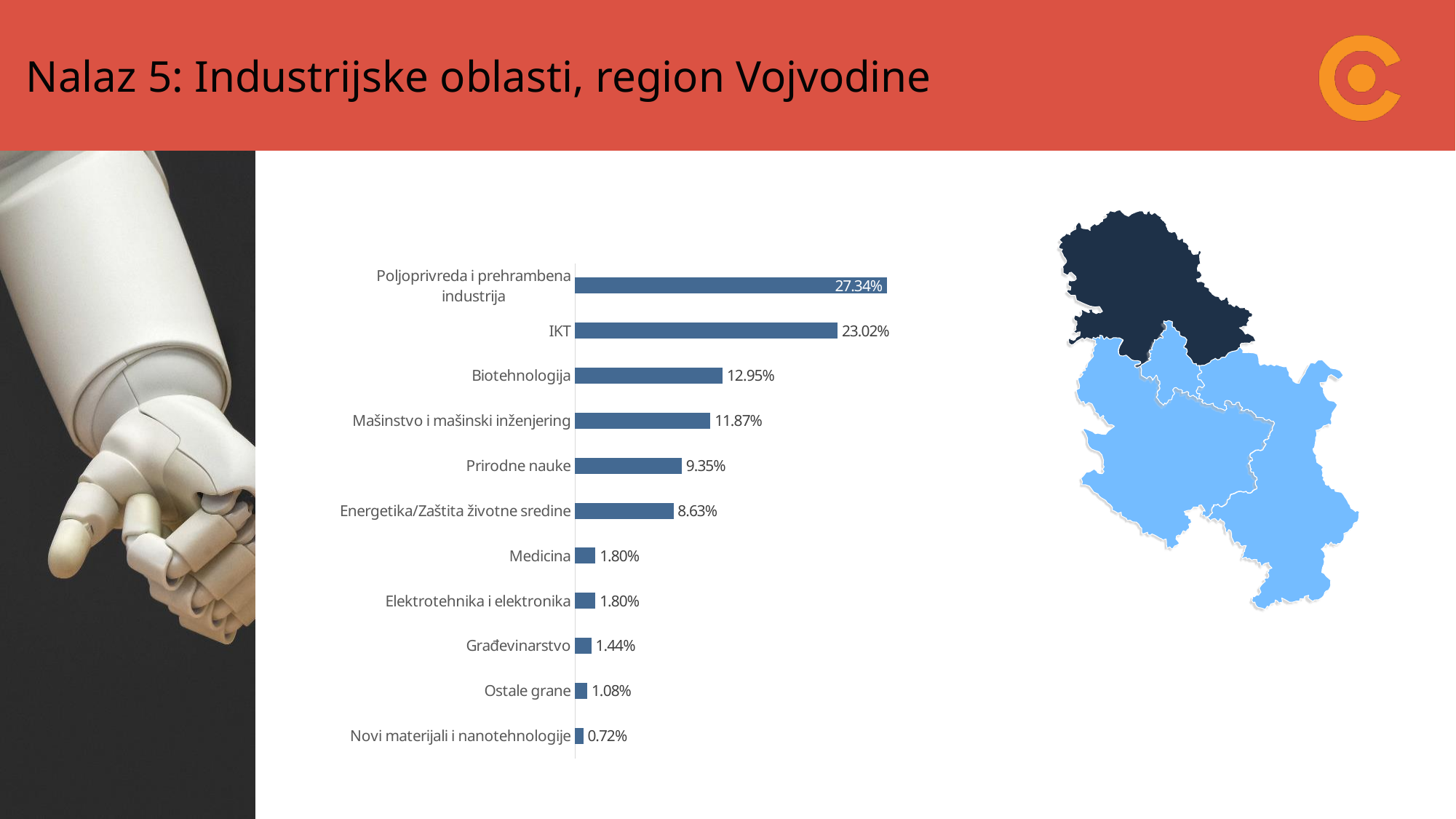
Which is larger, the value for Mašinstvo i mašinski inženjering or the value for Prirodne nauke? Mašinstvo i mašinski inženjering What is the difference between the values for Medicina and Ostale grane? 0.72% What kind of chart is shown on the slide? Bar chart What is the value for Energetika/Zaštita životne sredine? 8.63% What is the difference between the values for Poljoprivreda i prehrambena industrija and IKT? 4.32% What is the title of the slide containing the chart? Nalaz 5: Industrijske oblasti, region Vojvodine How many categories are shown in the bar chart? 11 Which category has the lowest value? Novi materijali i nanotehnologije Which category has the highest value? Poljoprivreda i prehrambena industrija What is the value for Građevinarstvo? 1.44% What is the value for IKT? 23.02% What is the value for Biotehnologija? 12.95%